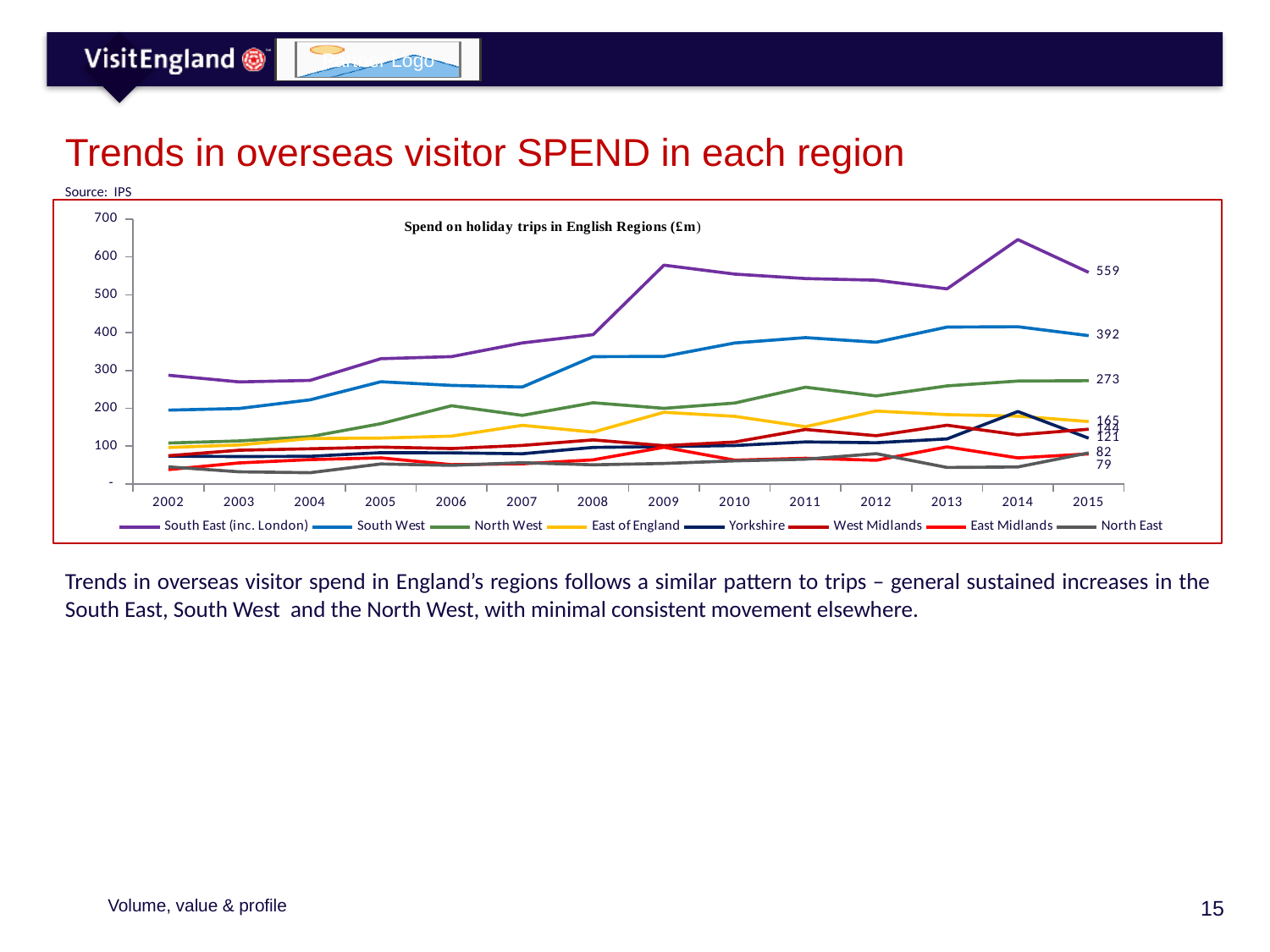
Is the value for South East (inc. London) in 2014 greater or less than 600? greater What kind of chart is shown on the slide? line chart What is the difference between the 2015 values for South East (inc. London) and South West? 167 What is the 2015 value for South West? 392 What is the title of the chart? Spend on holiday trips in English Regions (£m) What is the 2015 value for North West? 273 Is the value for South West in 2002 greater or less than 300? less In 2015, which is larger: South West or North West? South West Which region has the highest spend in 2015? South East (inc. London) What is the 2015 value for South East (inc. London)? 559 How many series does the legend list? 8 How many years are plotted along the x axis? 14